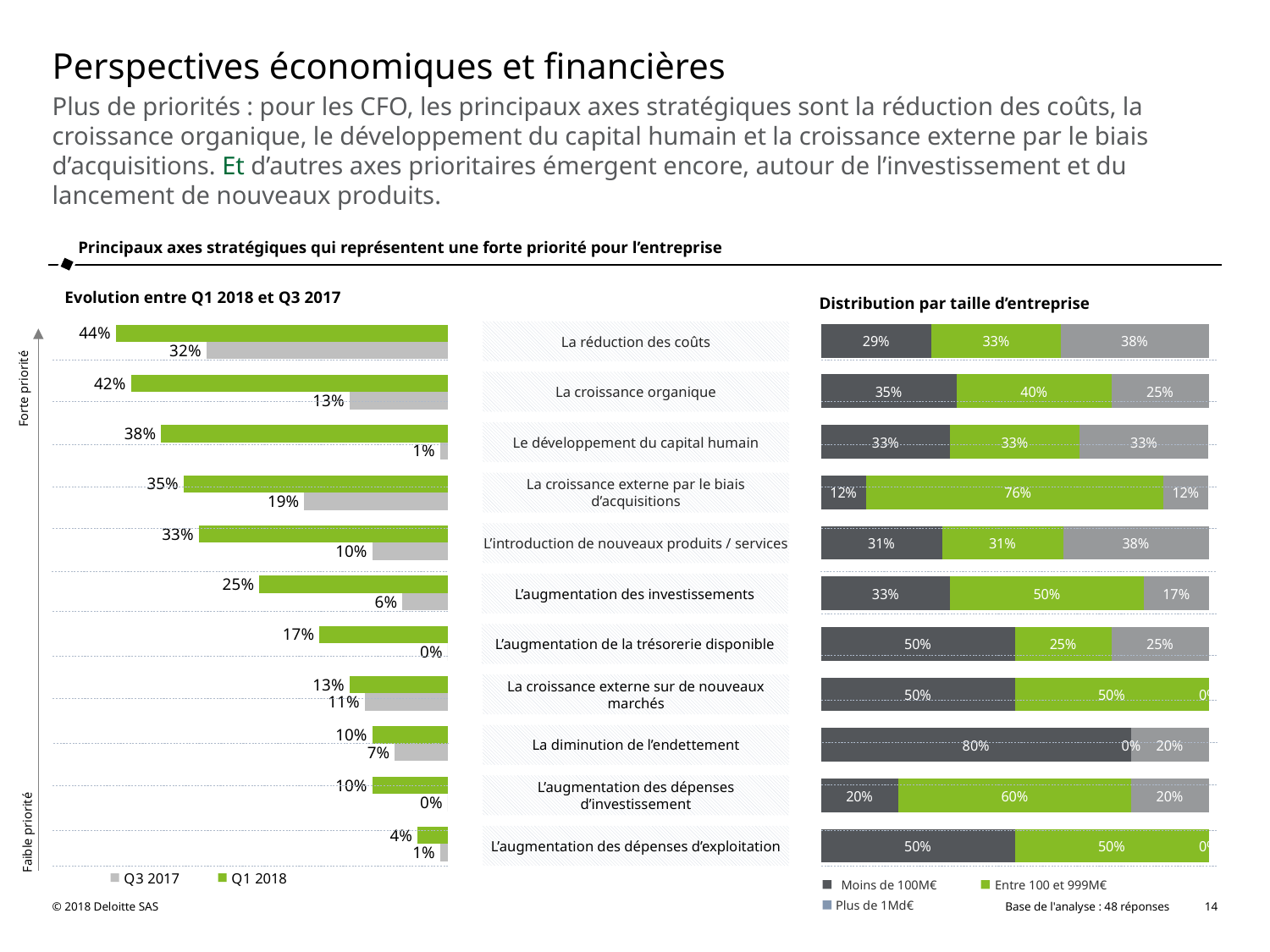
What kind of chart is 'Distribution par taille d'entreprise'? Stacked bar chart What are the two series listed in the legend of the chart 'Evolution entre Q1 2018 et Q3 2017'? Q3 2017 and Q1 2018 How many categories are shown in the chart 'Evolution entre Q1 2018 et Q3 2017'? 11 In the chart 'Evolution entre Q1 2018 et Q3 2017', what is the Q3 2017 value for 'La croissance organique'? 13% In the chart 'Evolution entre Q1 2018 et Q3 2017', which category has the highest Q1 2018 value? La réduction des coûts In the chart 'Evolution entre Q1 2018 et Q3 2017', what is the Q1 2018 value for 'La réduction des coûts'? 44% In the chart 'Distribution par taille d'entreprise', what is the value for 'Entre 100 et 999M€' for 'La croissance externe par le biais d'acquisitions'? 76% In the chart 'Distribution par taille d'entreprise', what is the value for 'Moins de 100M€' for 'La diminution de l'endettement'? 80% In the chart 'Evolution entre Q1 2018 et Q3 2017', which is larger for 'La croissance externe par le biais d'acquisitions': the Q1 2018 value or the Q3 2017 value? Q1 2018 In the chart 'Evolution entre Q1 2018 et Q3 2017', which category has the lowest Q1 2018 value? L'augmentation des dépenses d'exploitation In the chart 'Evolution entre Q1 2018 et Q3 2017', what is the difference between the Q1 2018 and Q3 2017 values for 'Le développement du capital humain'? 37 percentage points How many series does the legend of the chart 'Distribution par taille d'entreprise' list? 3